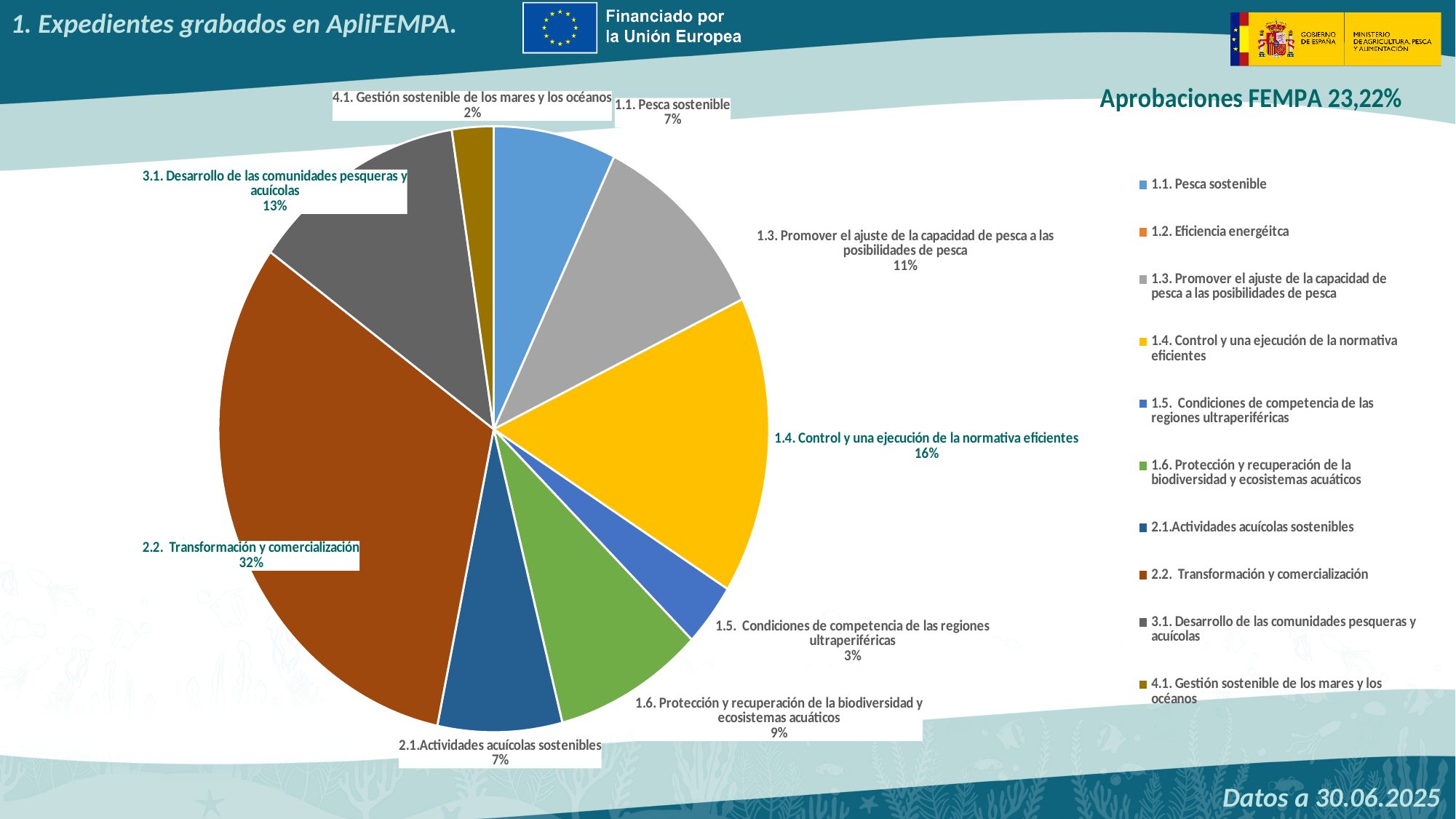
What is the value shown for "1.6. Protección y recuperación de la biodiversidad y ecosistemas acuáticos"? 9% Which is larger: the share for "1.3. Promover el ajuste de la capacidad de pesca a las posibilidades de pesca" or for "1.6. Protección y recuperación de la biodiversidad y ecosistemas acuáticos"? 1.3. Promover el ajuste de la capacidad de pesca a las posibilidades de pesca Which category has the largest slice of the pie? 2.2. Transformación y comercialización What share of the pie does "2.2. Transformación y comercialización" represent? 32% What is the difference in percentage points between "2.2. Transformación y comercialización" and "1.4. Control y una ejecución de la normativa eficientes"? 16 What is the value shown for "1.4. Control y una ejecución de la normativa eficientes"? 16% What is the value shown for "1.5. Condiciones de competencia de las regiones ultraperiféricas"? 3% How many entries does the legend list? 10 Which labelled slice has the smallest share of the pie? 4.1. Gestión sostenible de los mares y los océanos What is the value shown for "3.1. Desarrollo de las comunidades pesqueras y acuícolas"? 13% What type of chart is shown on the slide? pie chart What colour is the slice for "1.4. Control y una ejecución de la normativa eficientes"? yellow